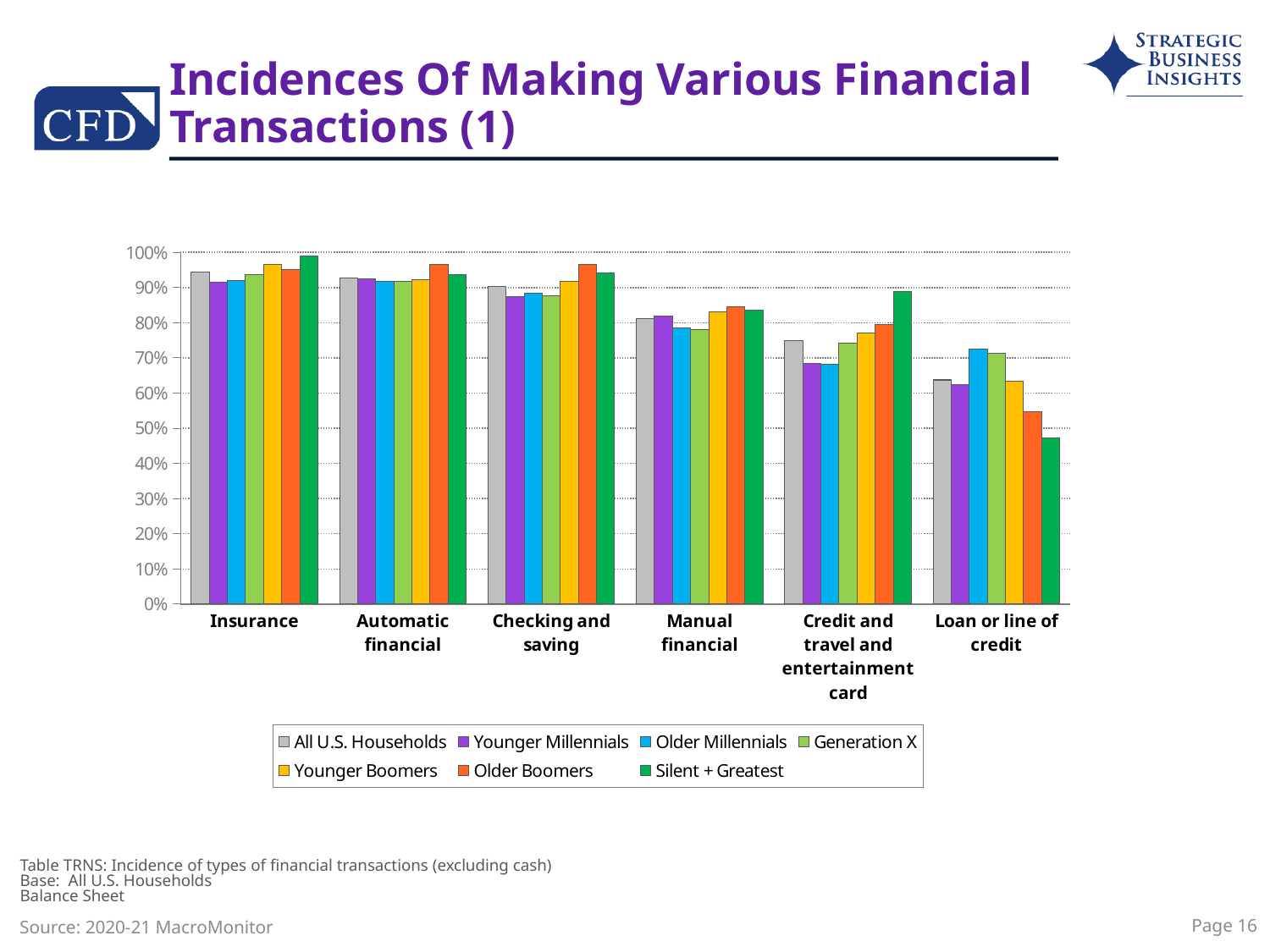
Do the values for All U.S. Households rise or fall moving from Insurance to Loan or line of credit along the x axis? fall Is the value for Silent + Greatest in the Credit and travel and entertainment card category greater or less than 80%? greater Is the value for Silent + Greatest in the Loan or line of credit category greater or less than 50%? less Which series is shown in gray in the legend? All U.S. Households In the Loan or line of credit category, which is larger: Older Millennials or Silent + Greatest? Older Millennials Is the value for Older Boomers in the Checking and saving category greater or less than 90%? greater How many transaction categories are shown on the x axis? 6 In the Credit and travel and entertainment card category, which series has the highest value? Silent + Greatest In the Loan or line of credit category, which series has the lowest value? Silent + Greatest How many series does the legend list? 7 What kind of chart is shown on the slide? Bar chart